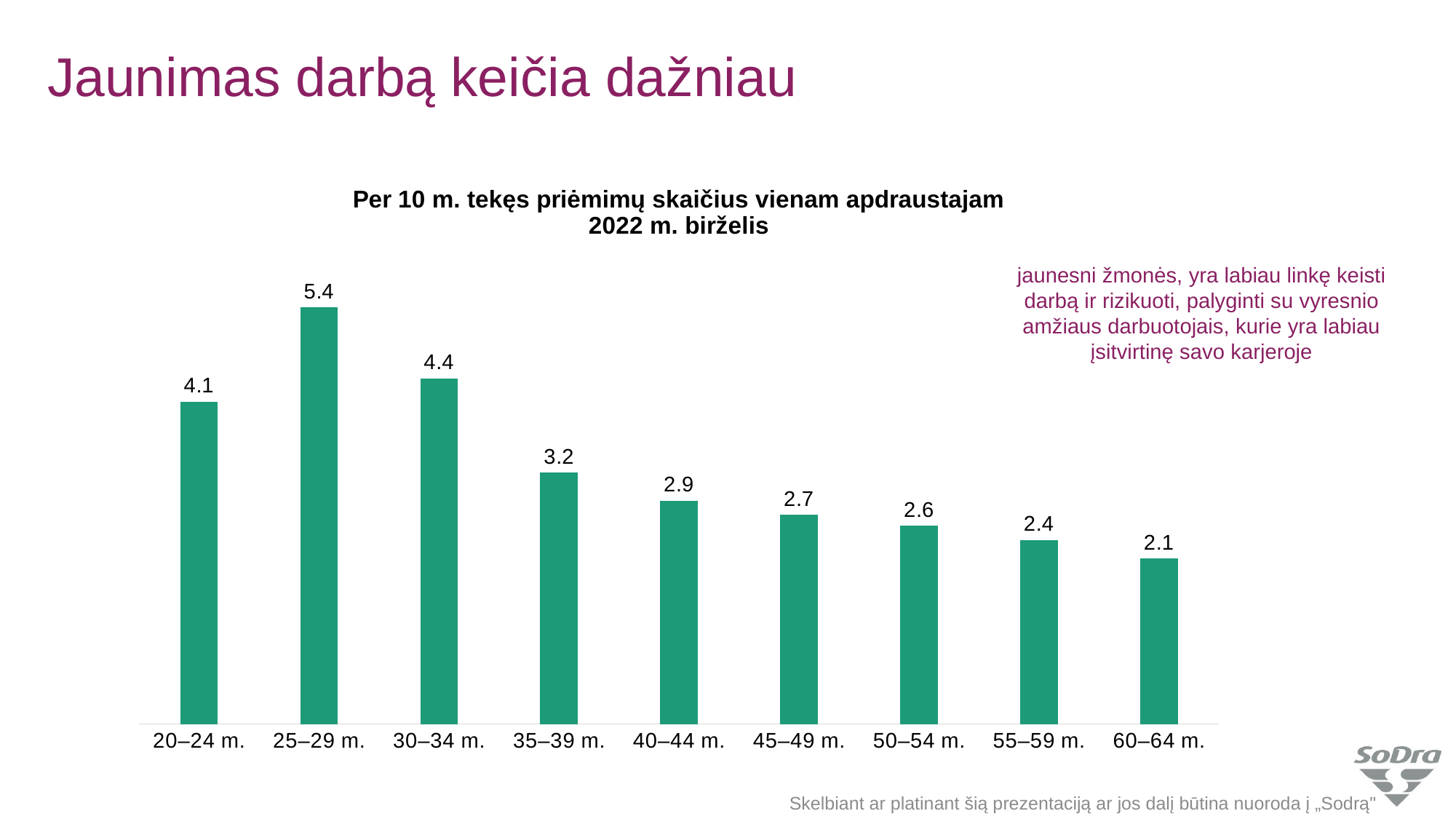
How many age groups are shown on the chart? 9 Which age group has the highest value? 25–29 m. Which is larger, the value for 20–24 m. or the value for 30–34 m.? 30–34 m. Which age group has the lowest value? 60–64 m. What kind of chart is shown on the slide? Bar chart What is the value for the 60–64 m. age group? 2.1 What is the difference between the values for 25–29 m. and 30–34 m.? 1.0 What is the value for the 25–29 m. age group? 5.4 From the 25–29 m. group onward, do the values rise or fall as age increases? Fall What is the title of the chart? Per 10 m. tekęs priėmimų skaičius vienam apdraustajam 2022 m. birželis What is the difference between the values for 20–24 m. and 60–64 m.? 2.0 What is the value for the 40–44 m. age group? 2.9